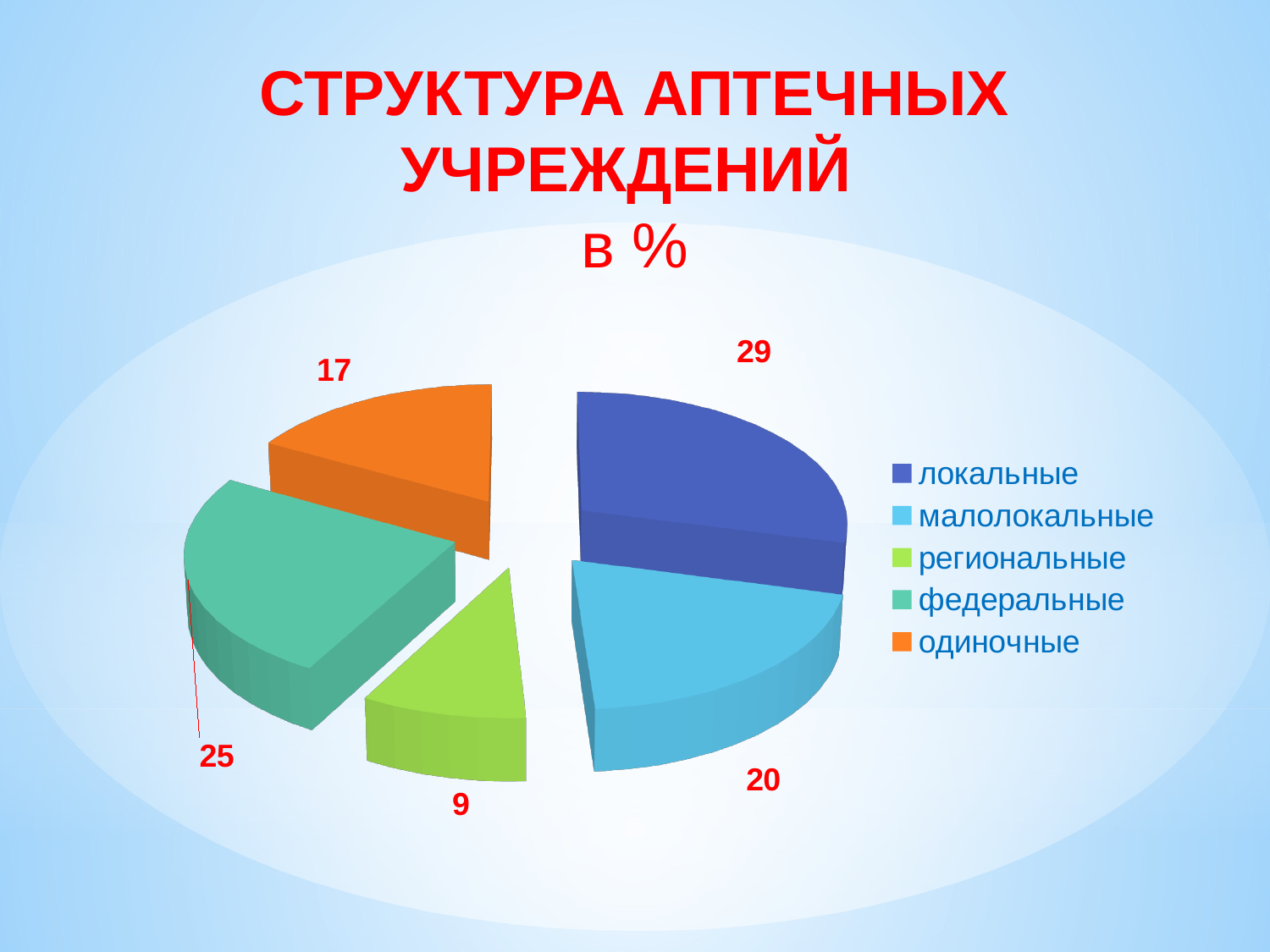
What is the value for локальные? 29 Which category has the smallest slice? региональные Which is larger, малолокальные or одиночные? малолокальные What is the difference between the values for локальные and федеральные? 4 What colour is the slice for одиночные? orange Which category has the largest slice? локальные What is the value for федеральные? 25 What is the value for региональные? 9 What is the value for одиночные? 17 How many categories does the pie chart have? 5 What is the value for малолокальные? 20 What kind of chart is shown on the slide? pie chart